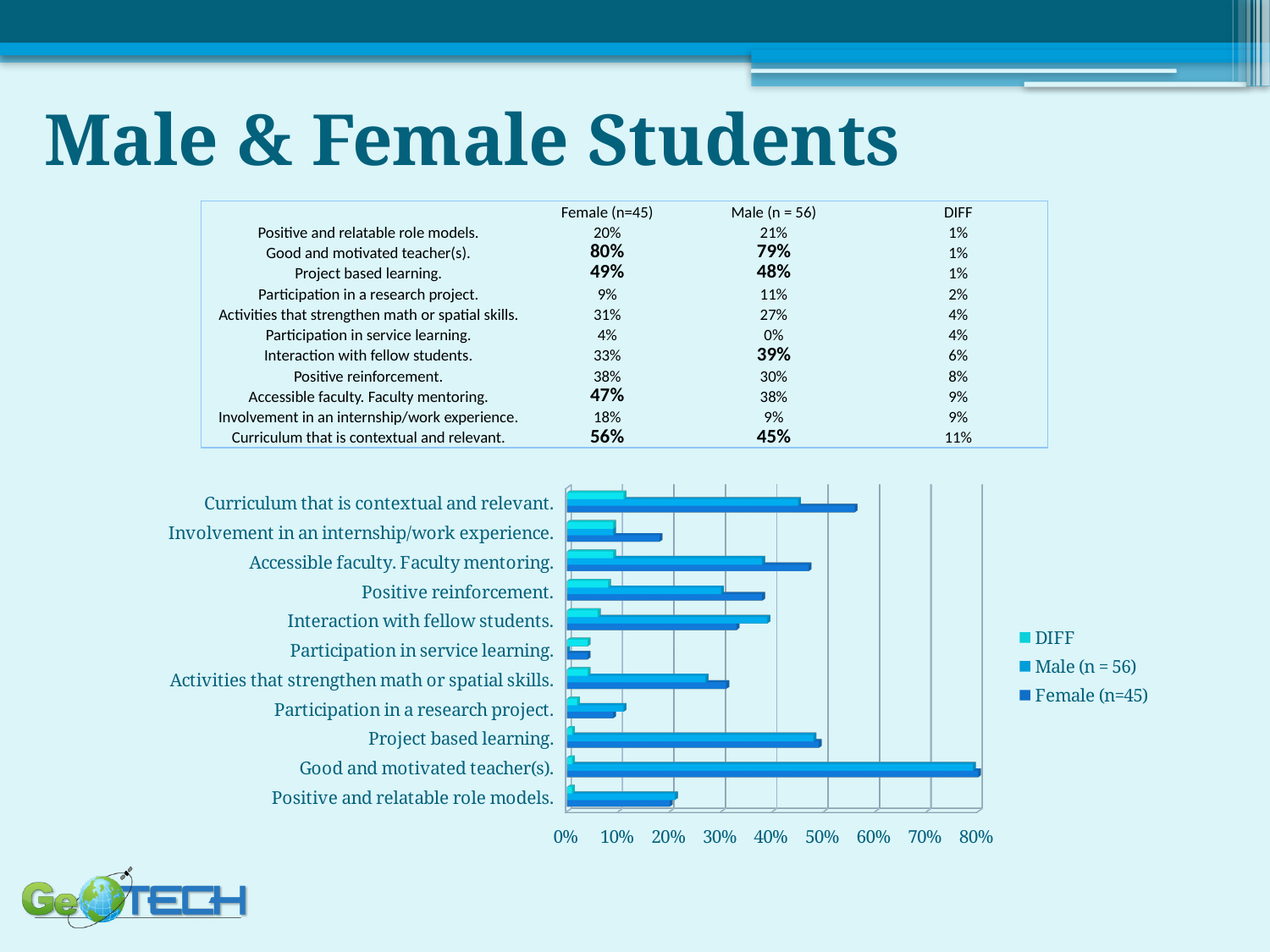
How many categories are plotted on the chart? 11 Which series is listed first in the chart legend? DIFF Is the Female (n=45) value for 'Accessible faculty. Faculty mentoring.' greater or less than 40%? greater What is the Female (n=45) value for 'Good and motivated teacher(s).'? 80% How many series does the chart legend list? 3 What is the difference between the Female (n=45) and Male (n = 56) values for 'Curriculum that is contextual and relevant.'? 11% For 'Interaction with fellow students.', which is larger: the Male (n = 56) value or the Female (n=45) value? Male (n = 56) Which category has the lowest Male (n = 56) value? Participation in service learning. What is the Male (n = 56) value for 'Curriculum that is contextual and relevant.'? 45% What is the DIFF value for 'Positive reinforcement.'? 8% What kind of chart is shown on the slide? bar chart Which category has the highest Female (n=45) value? Good and motivated teacher(s).